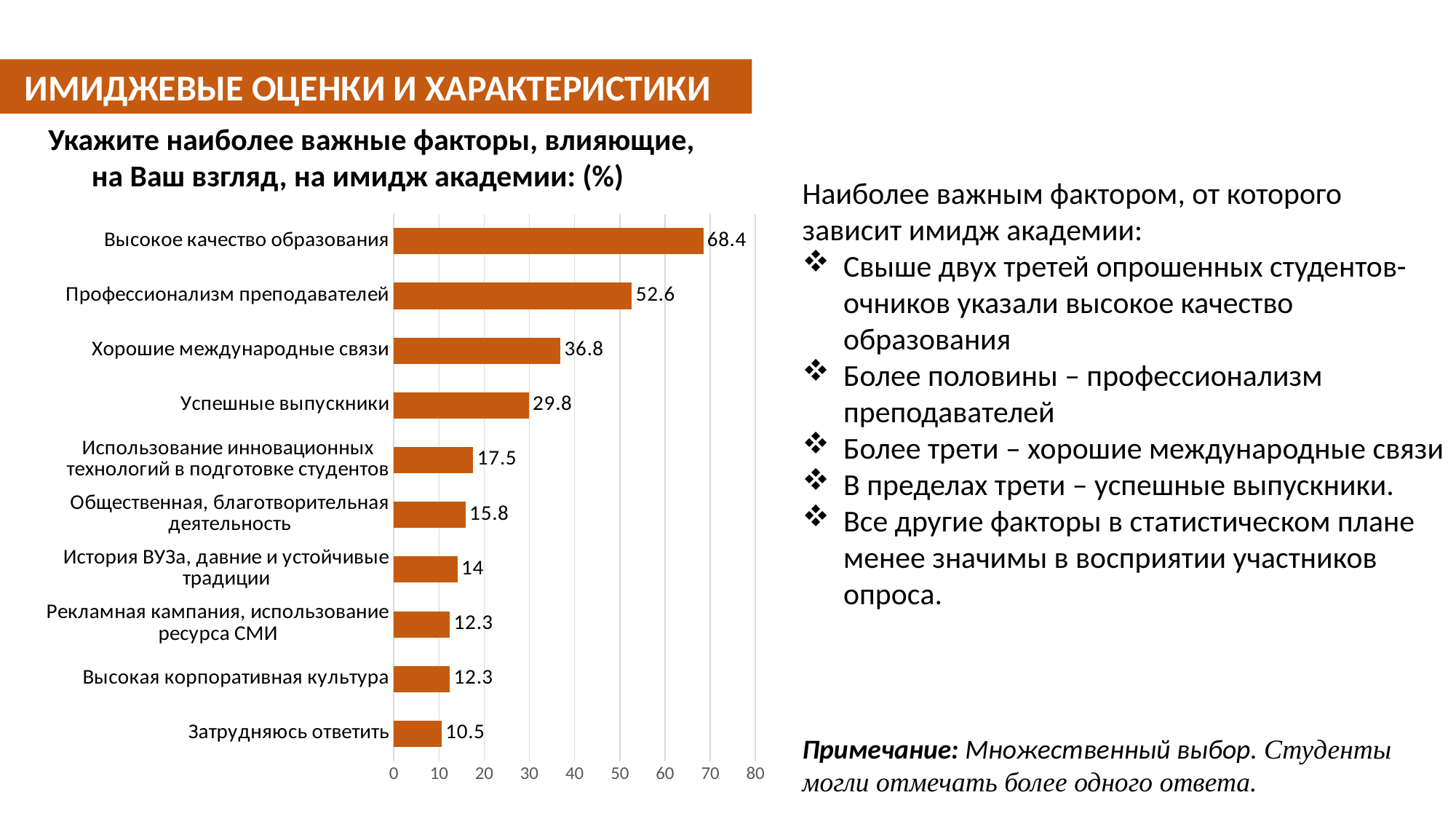
Is the value for «Профессионализм преподавателей» greater or less than 50? greater What value is shown for «История ВУЗа, давние и устойчивые традиции»? 14 Which is larger: the value for «Успешные выпускники» or the value for «Использование инновационных технологий в подготовке студентов»? Успешные выпускники What value is shown for «Высокое качество образования»? 68.4 What is the difference between the values for «Хорошие международные связи» and «Успешные выпускники»? 7 What is the title of the chart? Укажите наиболее важные факторы, влияющие, на Ваш взгляд, на имидж академии: (%) Which category has the highest value in the chart? Высокое качество образования What is the difference between the values for «Высокое качество образования» and «Профессионализм преподавателей»? 15.8 What value is shown for «Хорошие международные связи»? 36.8 Which category has the lowest value in the chart? Затрудняюсь ответить What kind of chart is shown on the slide? Bar chart How many categories are shown in the chart? 10